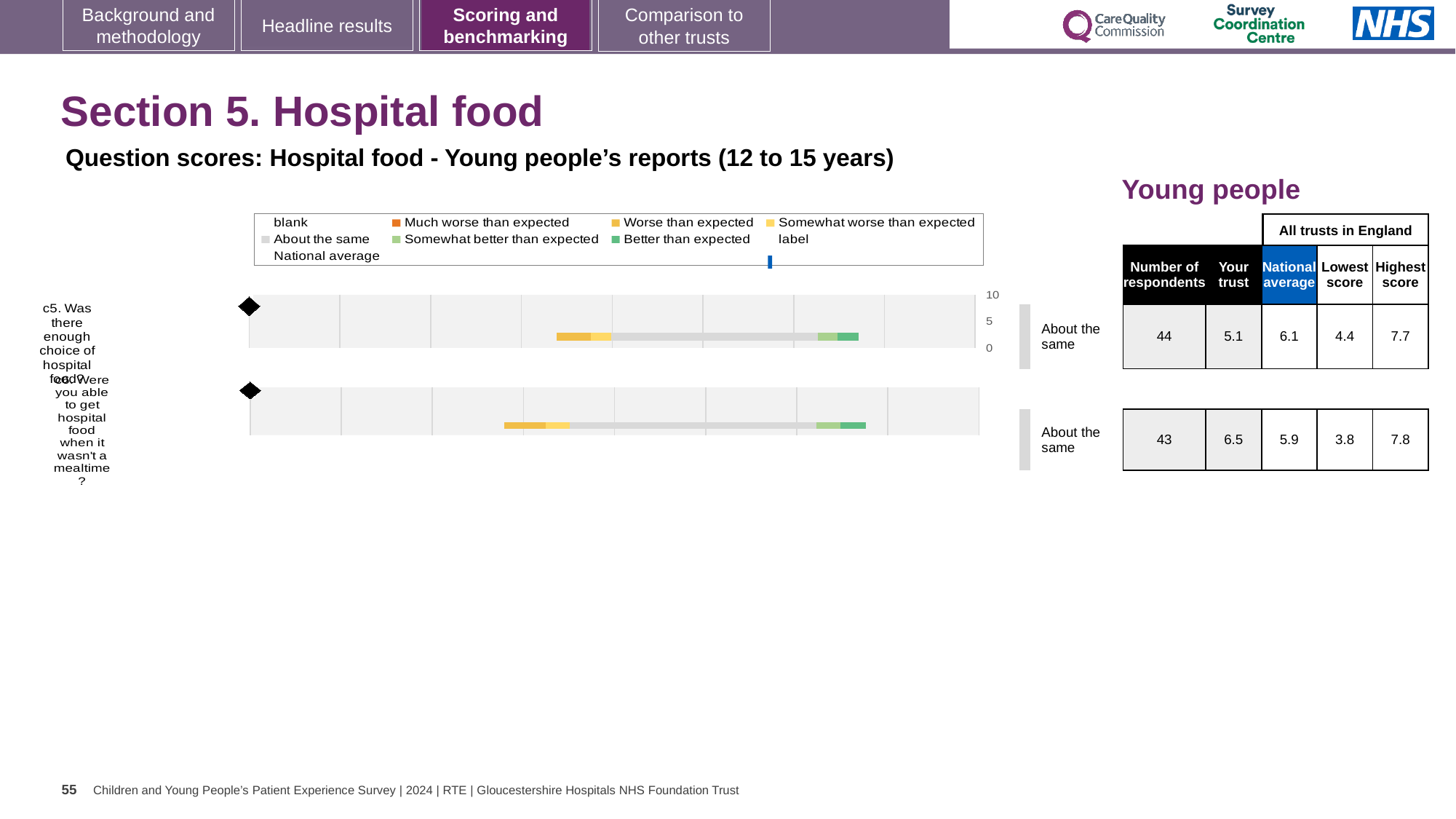
What is the difference between the 'Your trust' scores for c6 (6.5) and c5 (5.1)? 1.4 Which legend entry is shown in blue in the hospital food chart? National average According to the table, what is the national average score for c5 'Was there enough choice of hospital food?'? 6.1 According to the table, what is the highest score among all trusts in England for c6 'Were you able to get hospital food when it wasn't a mealtime?'? 7.8 According to the table, what is the 'Your trust' score for c6 'Were you able to get hospital food when it wasn't a mealtime?'? 6.5 How many questions are plotted in the hospital food chart? 2 What benchmark category is given for c5 'Was there enough choice of hospital food?'? About the same What is the highest value shown on the chart's score axis? 10 Which question has the higher 'Your trust' score, c5 or c6? c6 According to the table, what is the 'Your trust' score for c5 'Was there enough choice of hospital food?'? 5.1 What kind of chart is used to show the question scores for hospital food? bar chart According to the table, how many respondents answered c6 'Were you able to get hospital food when it wasn't a mealtime?'? 43